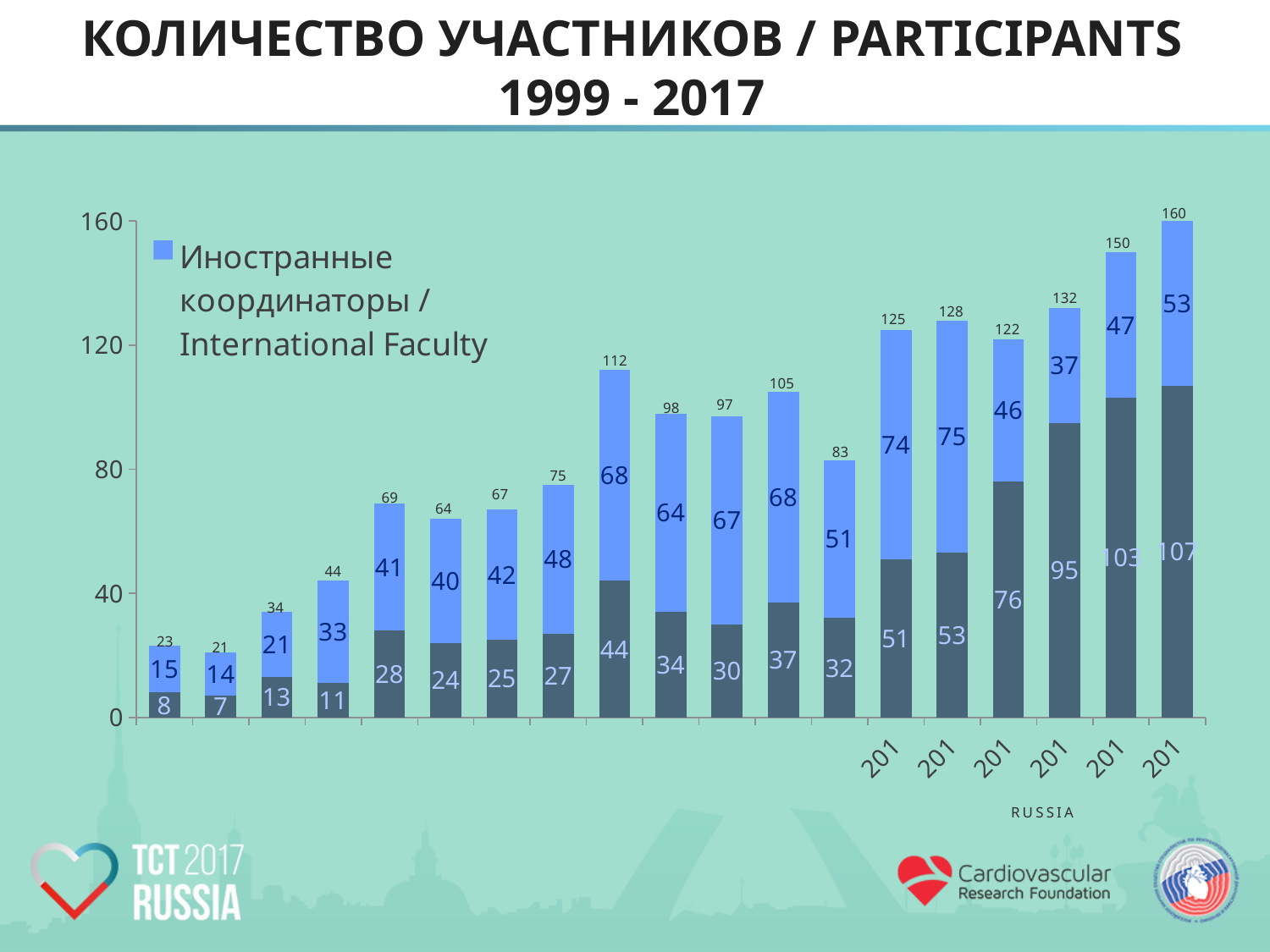
What is the total value labelled above the tallest (rightmost) bar? 160 What is the total value labelled above the first (leftmost) bar? 23 What is the value of the dark lower segment in the rightmost bar? 107 What is the legend entry shown for the light blue series? Иностранные координаторы / International Faculty What kind of chart is shown on the slide? stacked bar chart What is the total value labelled above the shortest bar (the second bar from the left)? 21 Is the total of the tallest bar greater or less than 120? greater What is the difference between the totals of the two rightmost bars (160 and 150)? 10 Which is larger: the International Faculty value in the rightmost bar or in the second-rightmost bar? the rightmost bar (53) Do the bar totals generally rise or fall from left to right? rise What is the International Faculty value in the rightmost bar? 53 How many bars are plotted in the chart? 19